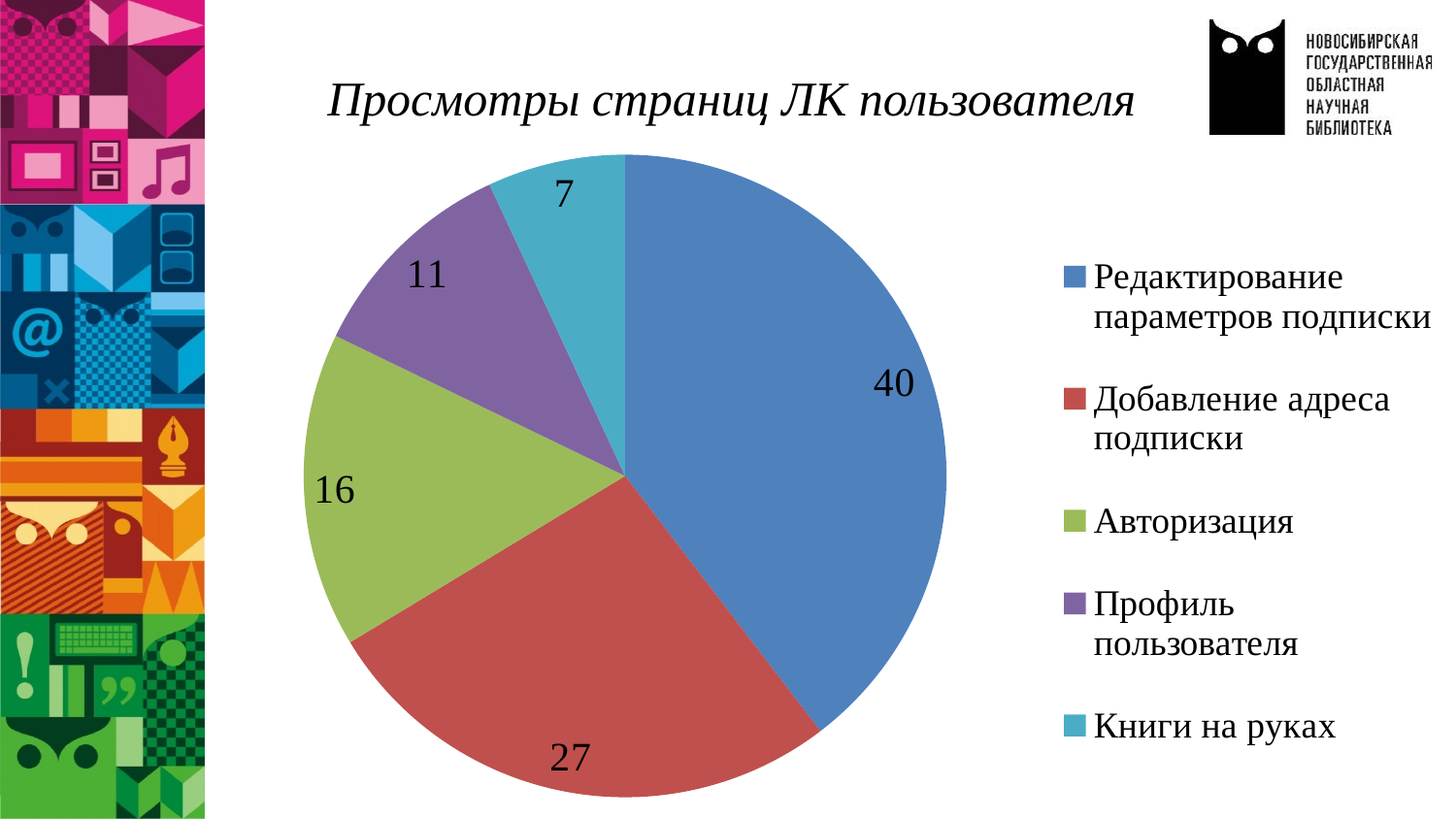
What is the value for Профиль пользователя? 11 What is the value for Книги на руках? 7 What is the value for Авторизация? 16 Which category has the smallest slice? Книги на руках What is the value for Добавление адреса подписки? 27 What is the title of the chart? Просмотры страниц ЛК пользователя What is the difference between the values for Редактирование параметров подписки and Добавление адреса подписки? 13 How many categories does the pie chart have? 5 What type of chart is shown on the slide? pie chart Which category has the largest slice? Редактирование параметров подписки What is the value for Редактирование параметров подписки? 40 Which is larger, the value for Авторизация or the value for Профиль пользователя? Авторизация